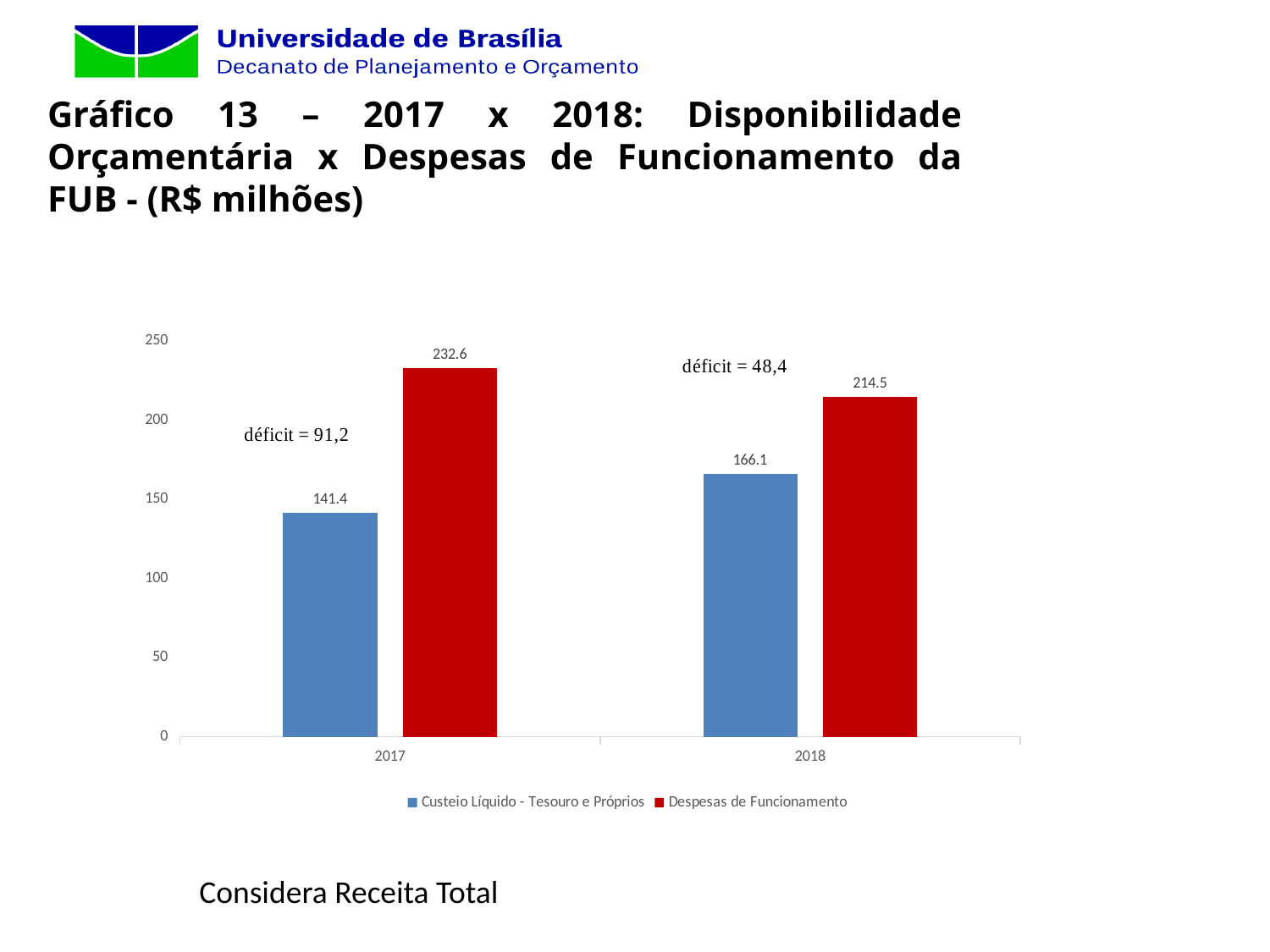
What is the value of Custeio Líquido - Tesouro e Próprios for 2018? 166.1 What kind of chart is shown on the slide? Bar chart What colour are the Despesas de Funcionamento bars? Red Which year has the lower value for Custeio Líquido - Tesouro e Próprios? 2017 How many years are shown on the x axis? 2 What is the difference between Despesas de Funcionamento and Custeio Líquido - Tesouro e Próprios in 2018? 48.4 What is the value of Despesas de Funcionamento for 2017? 232.6 Which year has the higher value for Despesas de Funcionamento? 2017 What is the value of Custeio Líquido - Tesouro e Próprios for 2017? 141.4 What is the value of Despesas de Funcionamento for 2018? 214.5 How many series does the legend list? 2 What is the difference between Despesas de Funcionamento in 2017 and in 2018? 18.1